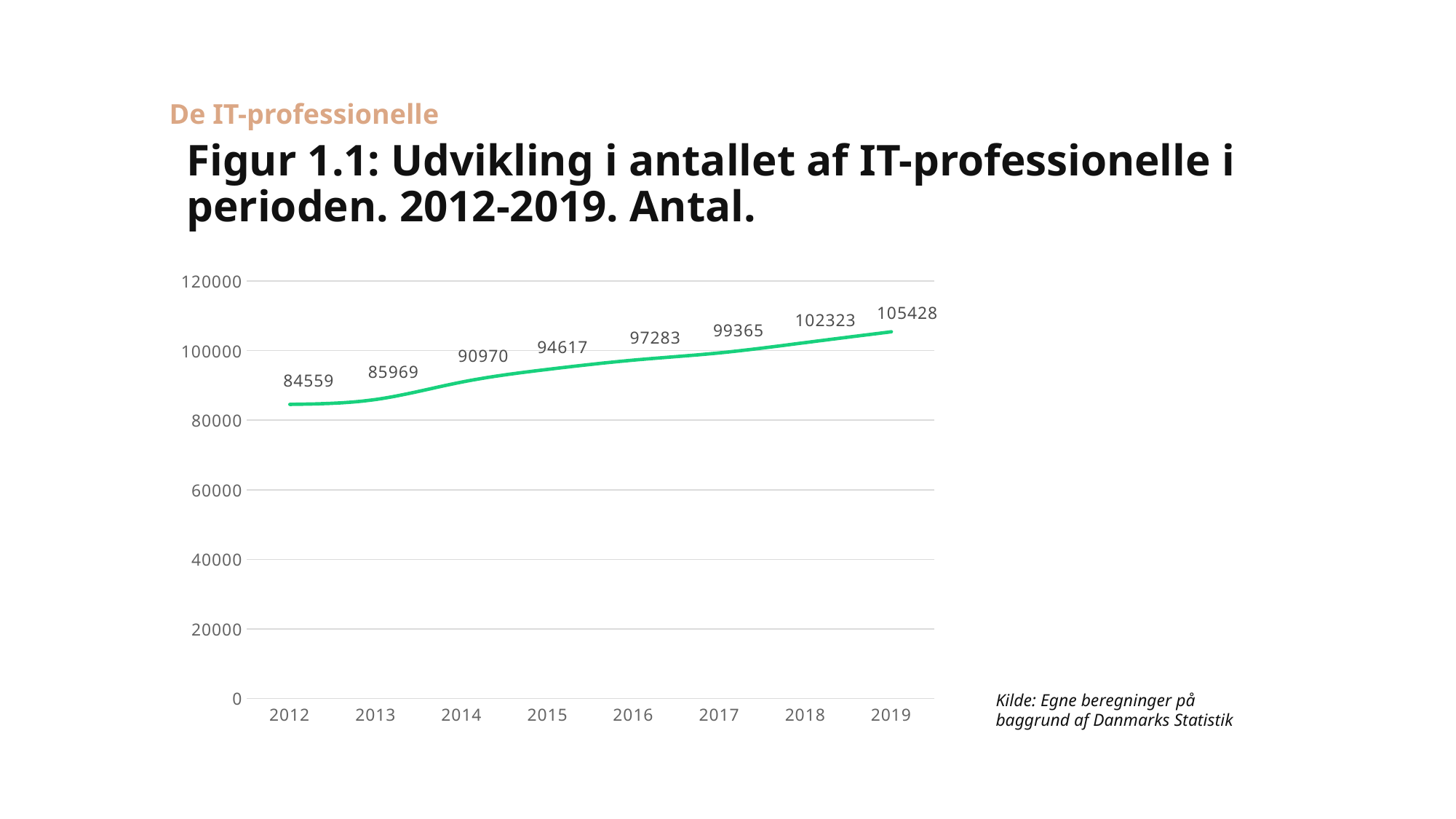
What is the number of IT-professionelle in 2019? 105428 Which year has the lowest number of IT-professionelle? 2012 How many years are plotted on the chart? 8 What is the number of IT-professionelle in 2012? 84559 What kind of chart is shown on the slide? line chart What is the value shown for 2015? 94617 What is the difference between the values for 2014 and 2013? 5001 Which is larger, the value for 2016 or the value for 2017? 2017 Do the values rise or fall from 2012 to 2019? rise What is the difference between the values for 2019 and 2012? 20869 What is the value shown for 2018? 102323 Which year has the highest number of IT-professionelle? 2019